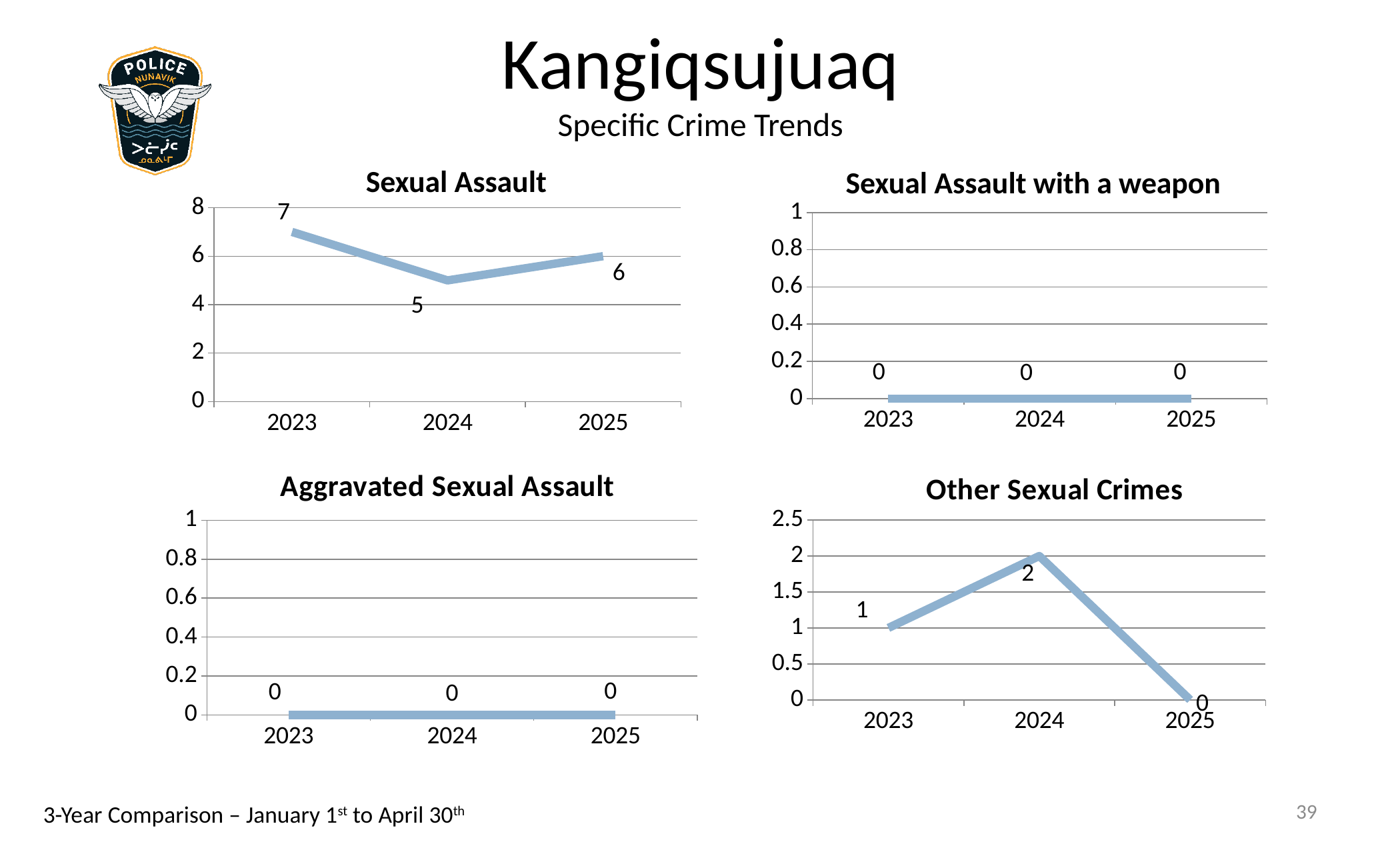
In the Aggravated Sexual Assault chart, how many years are plotted on the x axis? 3 In the Sexual Assault chart, which year has the highest value? 2023 In the Sexual Assault chart, what is the value for 2024? 5 In the Sexual Assault chart, is the value for 2025 greater or less than 4? greater In the Sexual Assault chart, which year has the lowest value? 2024 In the Other Sexual Crimes chart, what is the value for 2024? 2 In the Other Sexual Crimes chart, is the value for 2023 larger or the value for 2025? 2023 In the Sexual Assault chart, what is the difference between the 2023 and 2025 values? 1 In the Sexual Assault chart, what is the value for 2023? 7 In the Other Sexual Crimes chart, which year has the highest value? 2024 What kind of chart is the Other Sexual Crimes chart? line chart In the Sexual Assault with a weapon chart, what is the value for 2024? 0